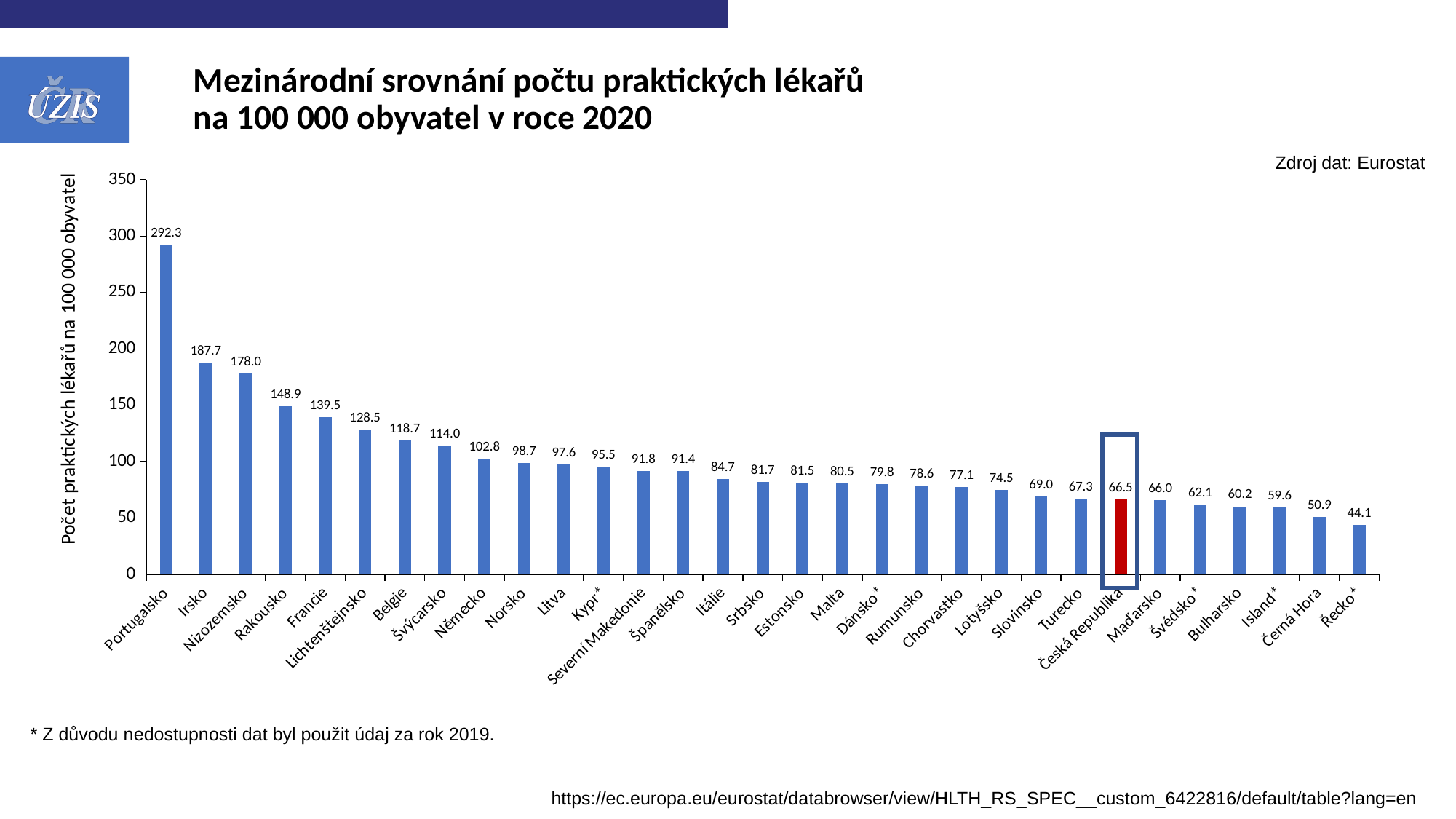
What is the value for Německo? 102.8 Which has a larger value, Francie or Belgie? Francie What is the value for Rakousko? 148.9 Which country has the lowest value? Řecko* What is the difference between the values for Portugalsko and Irsko? 104.6 What kind of chart is shown on the slide? bar chart What is the value for Česká Republika? 66.5 Which bar is highlighted in red? Česká Republika How many countries are shown in the chart? 31 Which country has the highest value? Portugalsko What is the difference between the values for Česká Republika and Řecko*? 22.4 Is the value for Nizozemsko greater or less than 150? greater